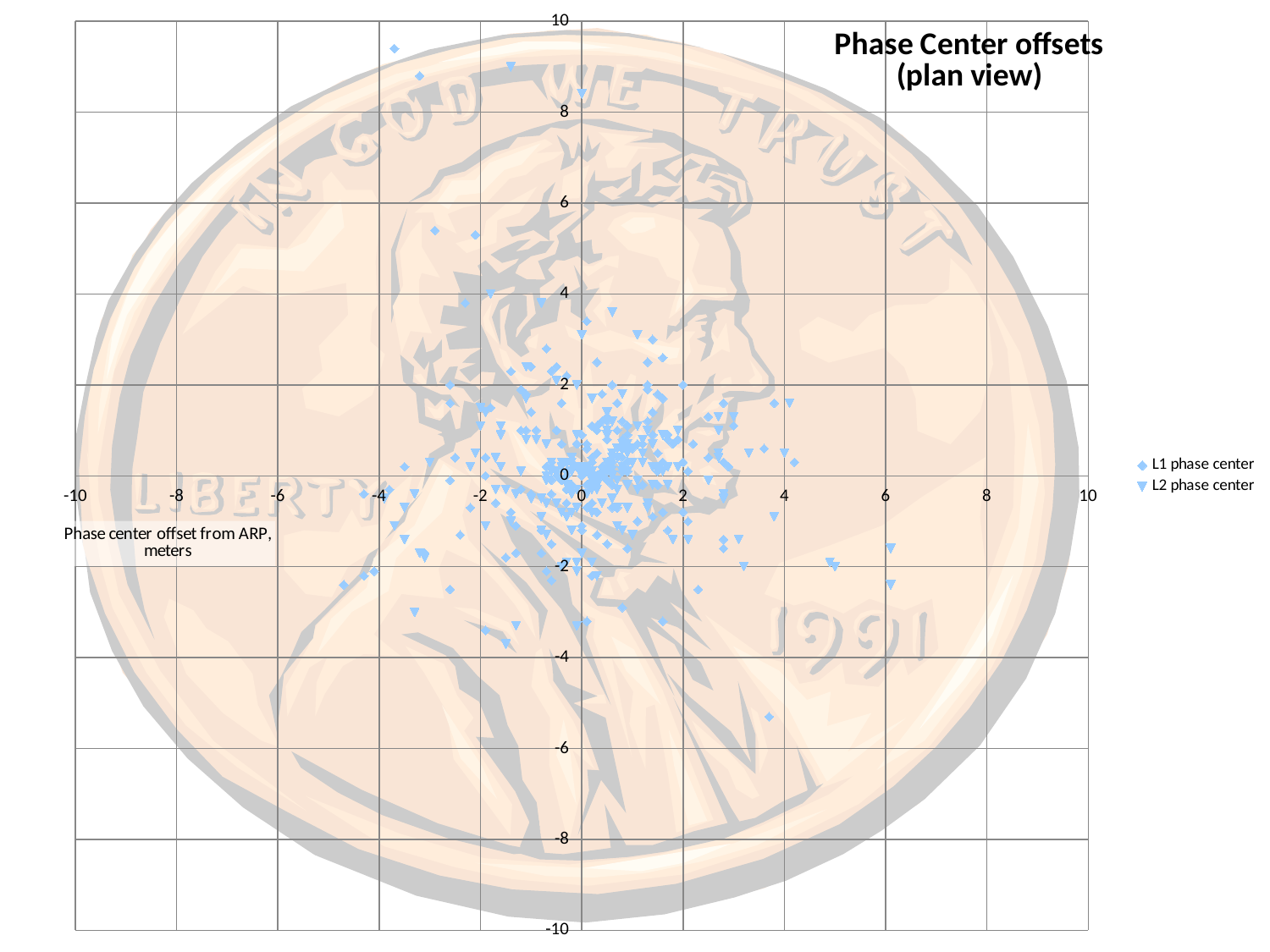
What kind of chart is shown on the slide? scatter chart Is the lowest vertical offset plotted on the chart greater or less than -4? less Is the largest horizontal offset plotted on the chart greater or less than 4? greater What is the title of the chart? Phase Center offsets (plan view) How many series does the legend list? 2 Is the smallest (most negative) horizontal offset plotted on the chart greater or less than -4? less What are the two series named in the legend? L1 phase center and L2 phase center